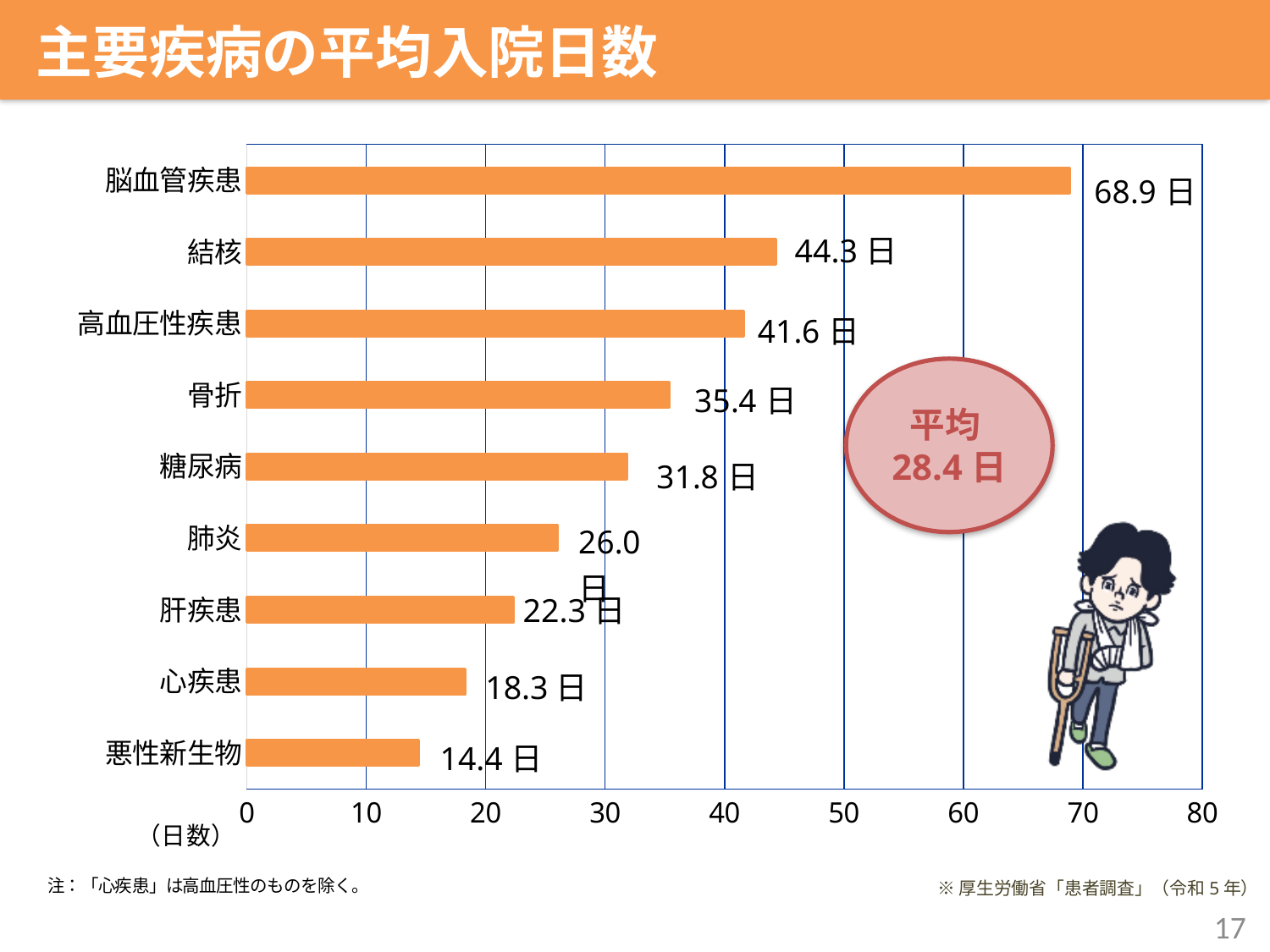
What is the average hospital stay for 脳血管疾患? 68.9 日 Which disease has the shortest average hospital stay? 悪性新生物 What is the value shown for 糖尿病? 31.8 日 What is the difference in days between 心疾患 and 悪性新生物? 3.9 日 What is the value shown for 心疾患? 18.3 日 What is the difference in days between 脳血管疾患 and 結核? 24.6 日 What overall average number of days is shown in the circle on the chart? 28.4 日 How many diseases are shown in the chart? 9 Is the value for 肝疾患 greater or less than 30? less What kind of chart is shown on the slide? bar chart Which disease has the longest average hospital stay? 脳血管疾患 Which has a longer average stay, 骨折 or 肺炎? 骨折